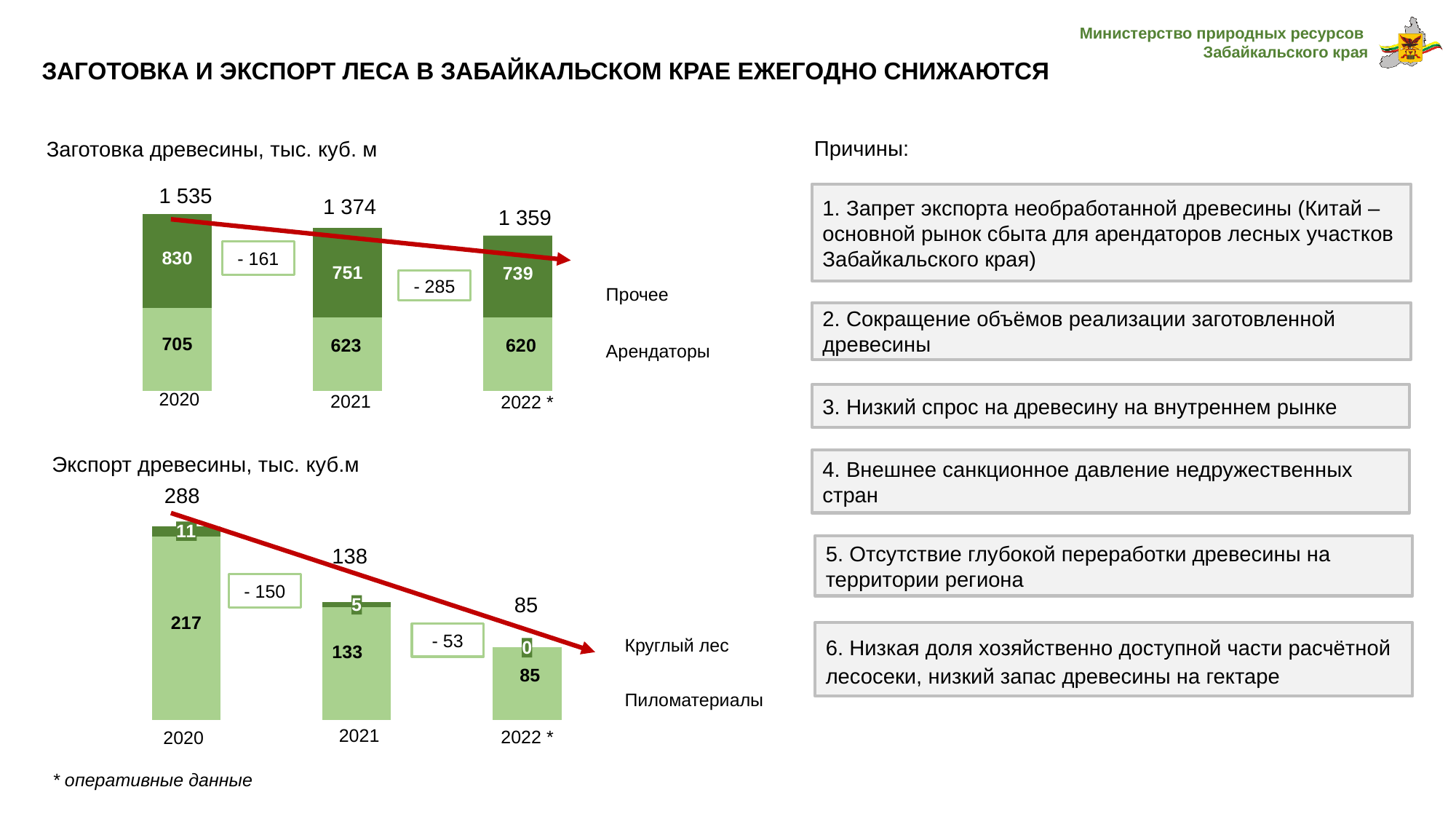
In the chart 'Заготовка древесины, тыс. куб. м', what is the value for Прочее in 2022? 739 In the chart 'Экспорт древесины, тыс. куб.м', do the totals rise or fall from 2020 to 2022? fall What kind of chart is 'Экспорт древесины, тыс. куб.м'? stacked bar chart In the chart 'Экспорт древесины, тыс. куб.м', which year has the lowest total? 2022 In the chart 'Заготовка древесины, тыс. куб. м', which year has the highest total? 2020 In the chart 'Экспорт древесины, тыс. куб.м', what is the total value for 2021? 138 In the chart 'Экспорт древесины, тыс. куб.м', what is the value for Круглый лес in 2022? 0 In the chart 'Заготовка древесины, тыс. куб. м', what is the difference between the Прочее values for 2020 and 2021? 79 In the chart 'Заготовка древесины, тыс. куб. м', what is the value for Арендаторы in 2021? 623 In the chart 'Заготовка древесины, тыс. куб. м', what is the total value for 2020? 1 535 In the chart 'Экспорт древесины, тыс. куб.м', what is the value for Пиломатериалы in 2020? 217